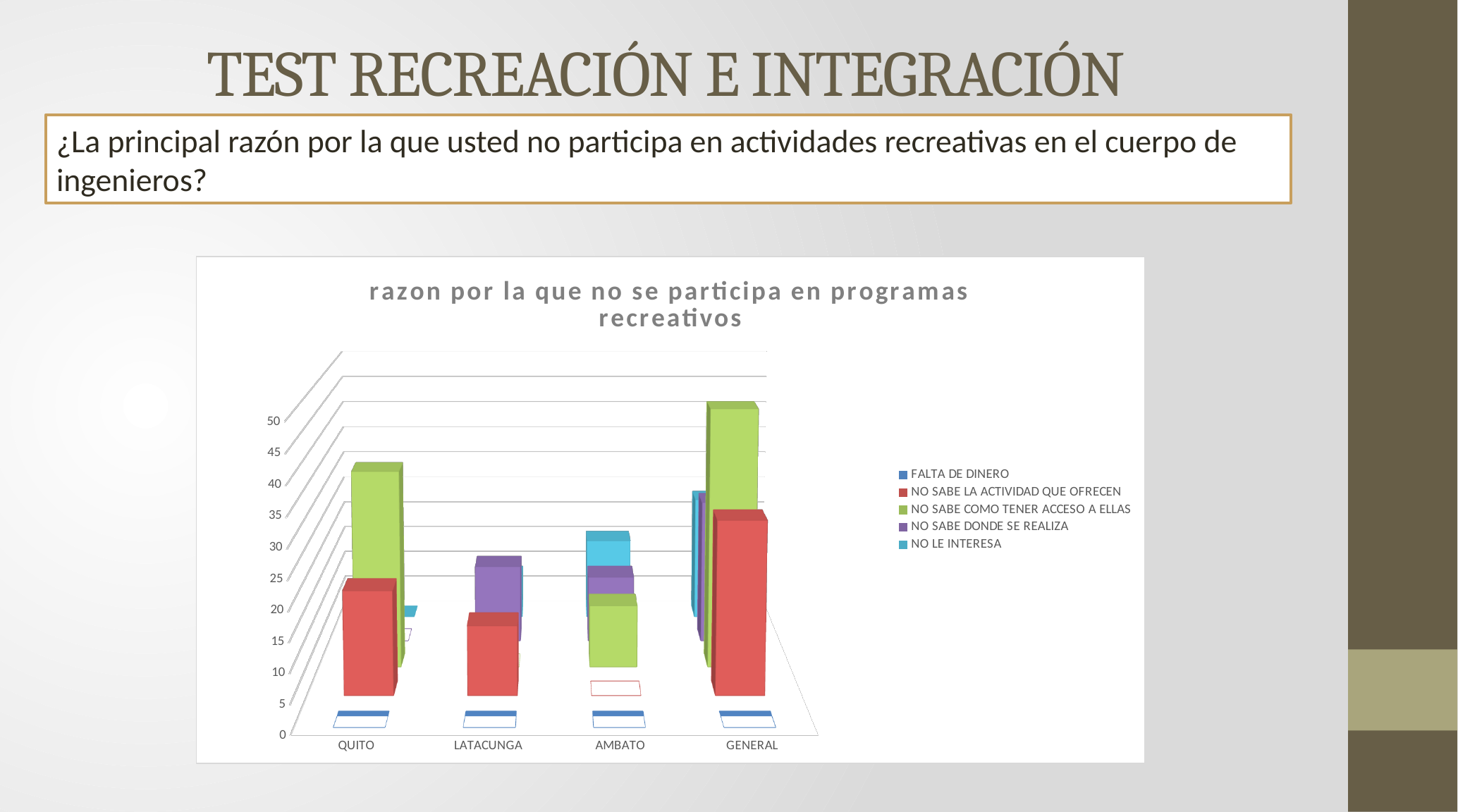
How many categories are shown on the x axis of the chart? 4 Which category has the highest value for NO SABE COMO TENER ACCESO A ELLAS? GENERAL Which legend entry is shown in green? NO SABE COMO TENER ACCESO A ELLAS What is the title of the chart? razon por la que no se participa en programas recreativos Is the value for FALTA DE DINERO in QUITO greater or less than 5? less Which is larger: NO SABE COMO TENER ACCESO A ELLAS in GENERAL or in AMBATO? GENERAL Is the value for NO SABE COMO TENER ACCESO A ELLAS in GENERAL greater or less than 25? greater In QUITO, which is larger: NO SABE LA ACTIVIDAD QUE OFRECEN or NO SABE COMO TENER ACCESO A ELLAS? NO SABE COMO TENER ACCESO A ELLAS How many series does the chart's legend list? 5 What kind of chart is shown on the slide? bar chart Which category has the lowest value for NO SABE LA ACTIVIDAD QUE OFRECEN? AMBATO Is the value for NO SABE LA ACTIVIDAD QUE OFRECEN in AMBATO greater or less than 5? less